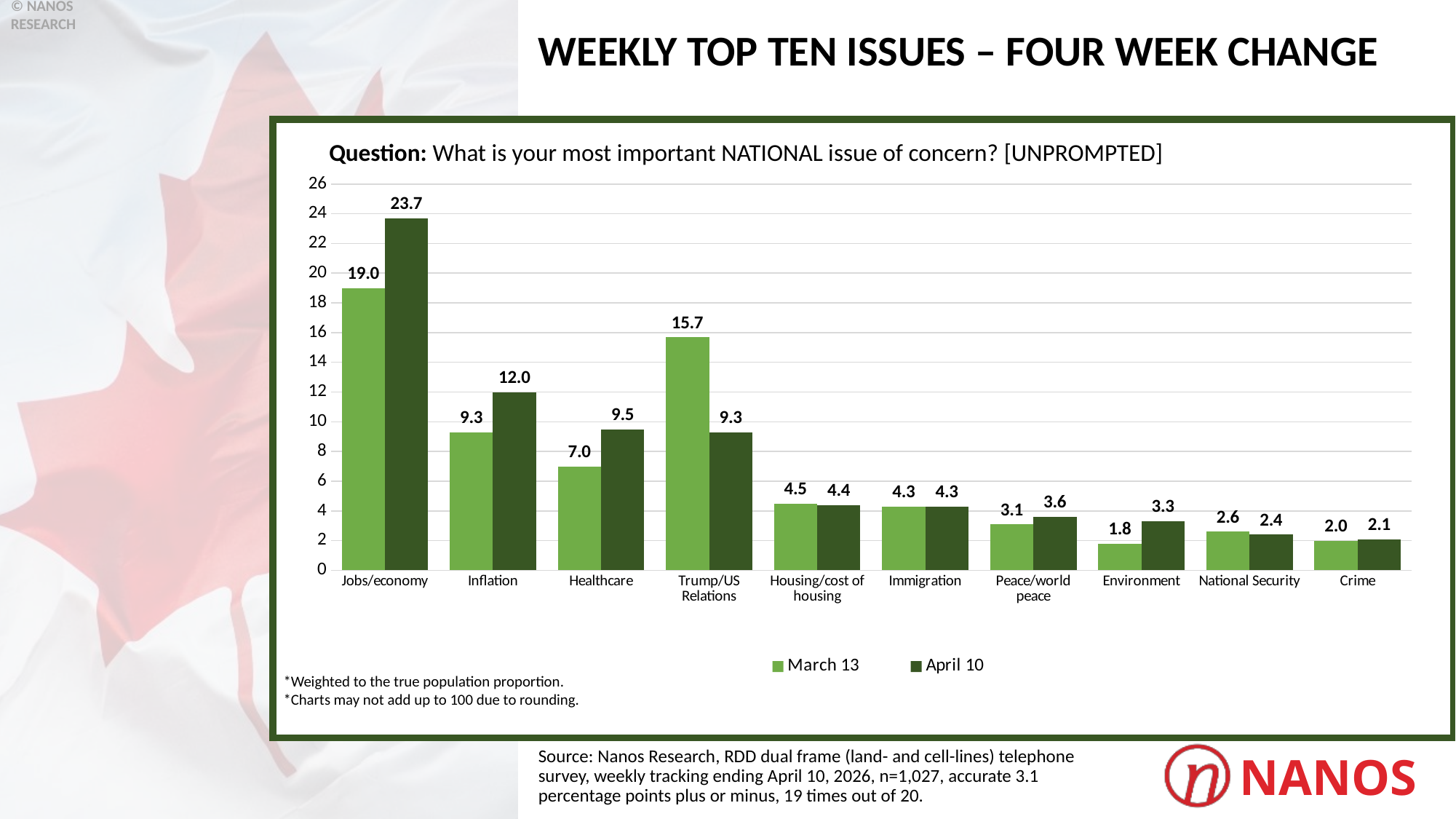
What kind of chart is shown on the slide? Bar chart What is the difference between the April 10 and March 13 values for Jobs/economy? 4.7 What is the difference between the March 13 and April 10 values for Trump/US Relations? 6.4 What is the March 13 value for Trump/US Relations? 15.7 How many series does the legend list? 2 What is the April 10 value for Jobs/economy? 23.7 What are the two series named in the legend? March 13 and April 10 Which is larger for Inflation: the March 13 value or the April 10 value? April 10 What is the April 10 value for Healthcare? 9.5 How many categories are shown on the x axis? 10 Which category has the highest April 10 value? Jobs/economy Which category has the lowest March 13 value? Environment